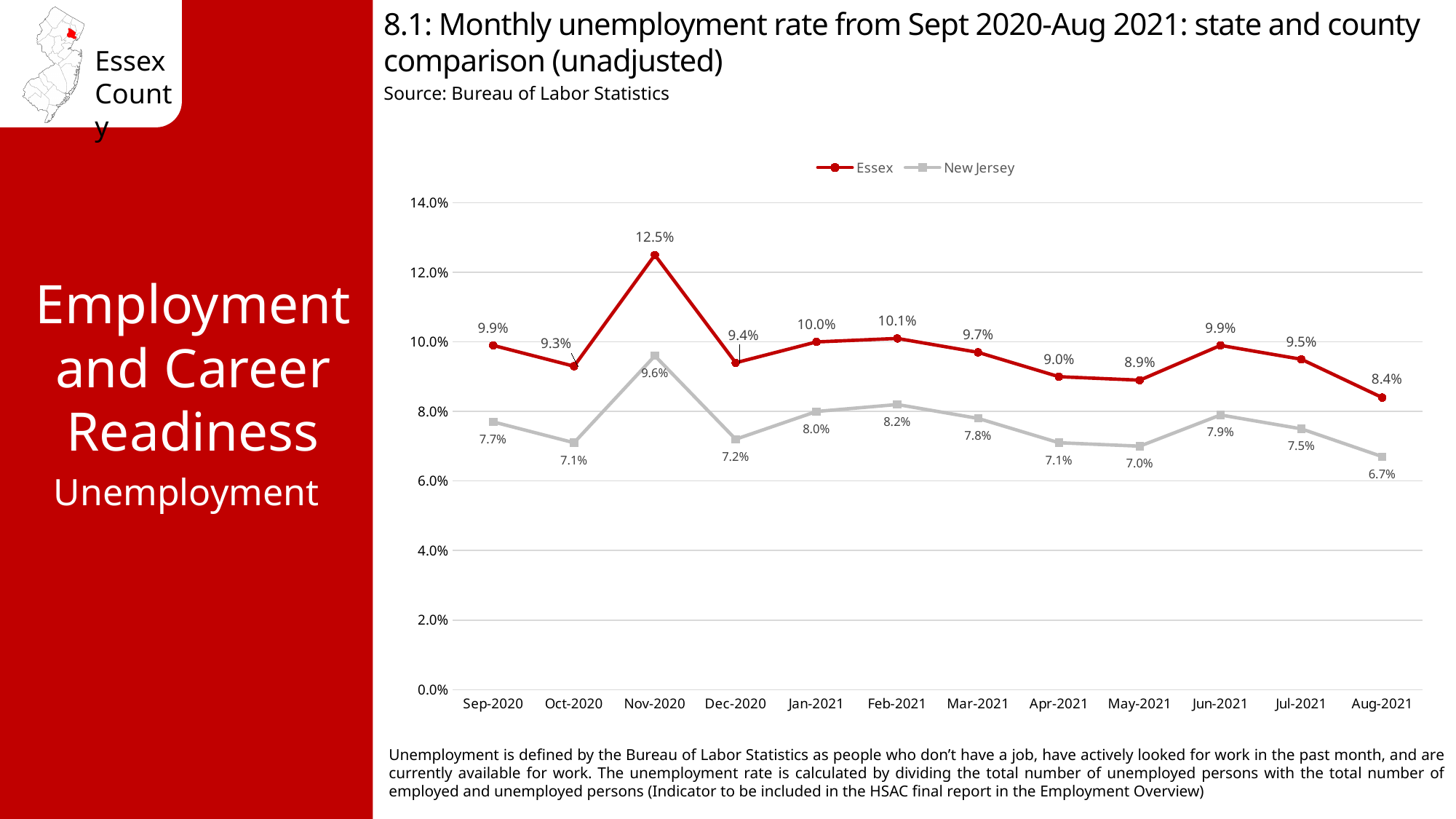
What was the Essex unemployment rate in Nov-2020? 12.5% What was the New Jersey unemployment rate in Aug-2021? 6.7% How many months are plotted on the x axis? 12 In which month was the Essex unemployment rate highest? Nov-2020 What is the difference between the Essex and New Jersey unemployment rates in Nov-2020? 2.9% Which had the higher unemployment rate in Feb-2021, Essex or New Jersey? Essex How many series does the legend list? 2 What is the source cited for the chart? Bureau of Labor Statistics Did the Essex unemployment rate rise or fall from Jun-2021 to Aug-2021? Fall In which month was the New Jersey unemployment rate lowest? Aug-2021 What kind of chart is shown on the slide? Line chart Is the Essex unemployment rate in Nov-2020 greater or less than 12.0%? greater